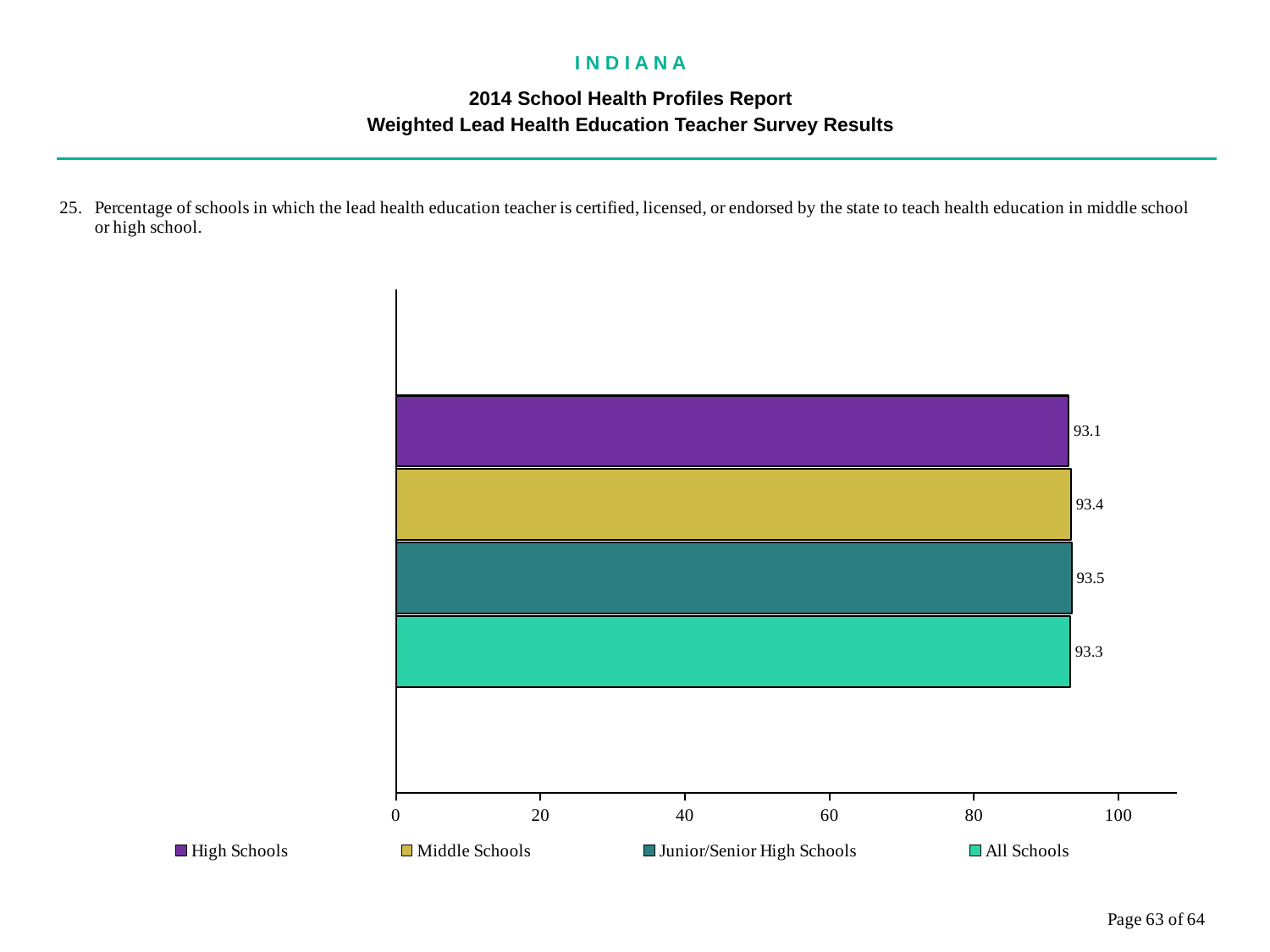
How many entries does the legend list? 4 What is the difference between the values for Junior/Senior High Schools and High Schools? 0.4 Which school type has the highest value? Junior/Senior High Schools What is the value for Middle Schools? 93.4 Which is larger, the value for Middle Schools or the value for All Schools? Middle Schools Which school type has the lowest value? High Schools Is the value for All Schools greater or less than 80? greater What is the value for Junior/Senior High Schools? 93.5 What kind of chart is shown on the slide? bar chart How many bars are shown in the chart? 4 What is the value for All Schools? 93.3 What is the value for High Schools? 93.1